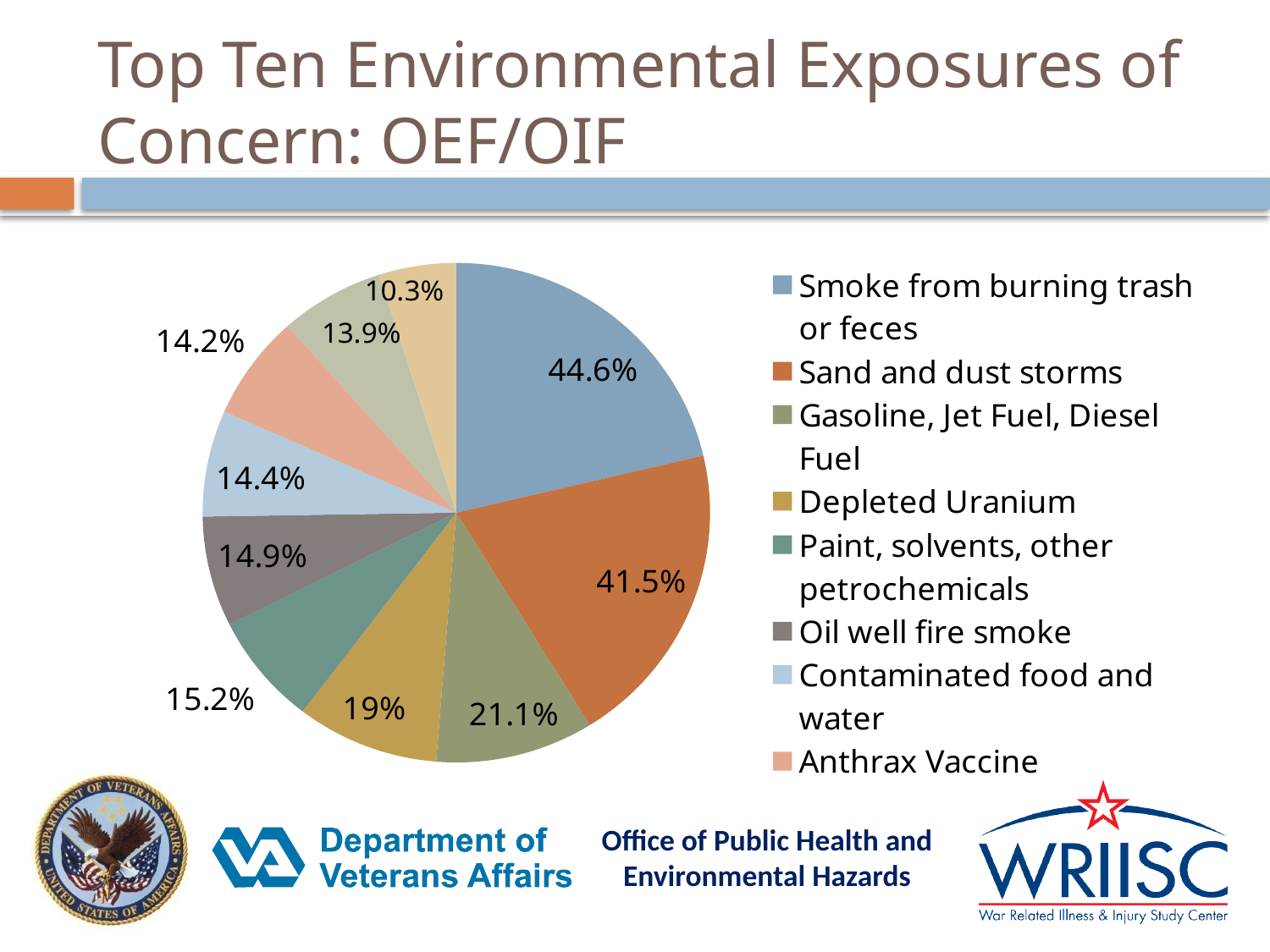
What is the value shown for Sand and dust storms? 41.5% Which exposure has the largest slice in the pie chart? Smoke from burning trash or feces How many slices does the pie chart have? 10 What is the title of the slide containing the pie chart? Top Ten Environmental Exposures of Concern: OEF/OIF What is the difference between the values for Smoke from burning trash or feces and Sand and dust storms? 3.1 percentage points What kind of chart is shown on the slide? pie chart What is the value shown for Smoke from burning trash or feces? 44.6% What is the smallest value labeled on the pie chart? 10.3% What is the value shown for Depleted Uranium? 19% What is the value shown for Oil well fire smoke? 14.9% What is the value shown for Anthrax Vaccine? 14.2% Which has a larger value: Gasoline, Jet Fuel, Diesel Fuel or Depleted Uranium? Gasoline, Jet Fuel, Diesel Fuel